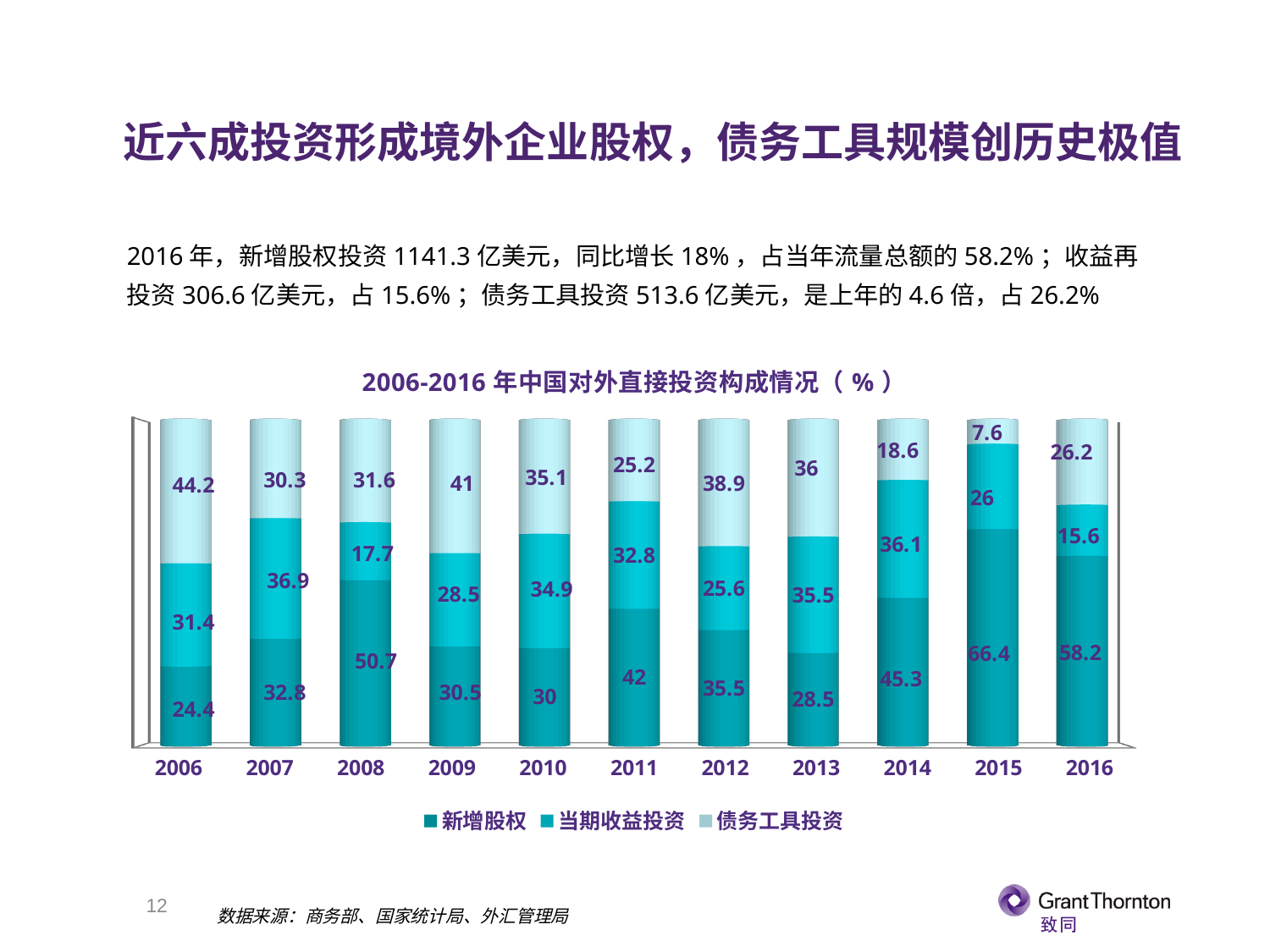
What is the value of 新增股权 for 2016? 58.2 What is the difference between the 新增股权 values for 2015 and 2016? 8.2 Which is larger, the 当期收益投资 value for 2007 or for 2012? 2007 What is the total of the stacked bar for 2010? 100 What is the title of the chart? 2006-2016 年中国对外直接投资构成情况（%） What is the value of 债务工具投资 for 2006? 44.2 How many years are shown on the x axis? 11 How many series does the legend list? 3 Which year has the lowest value for 债务工具投资? 2015 Which year has the highest value for 新增股权? 2015 What kind of chart is shown on the slide? Stacked bar chart What is the value of 当期收益投资 for 2008? 17.7